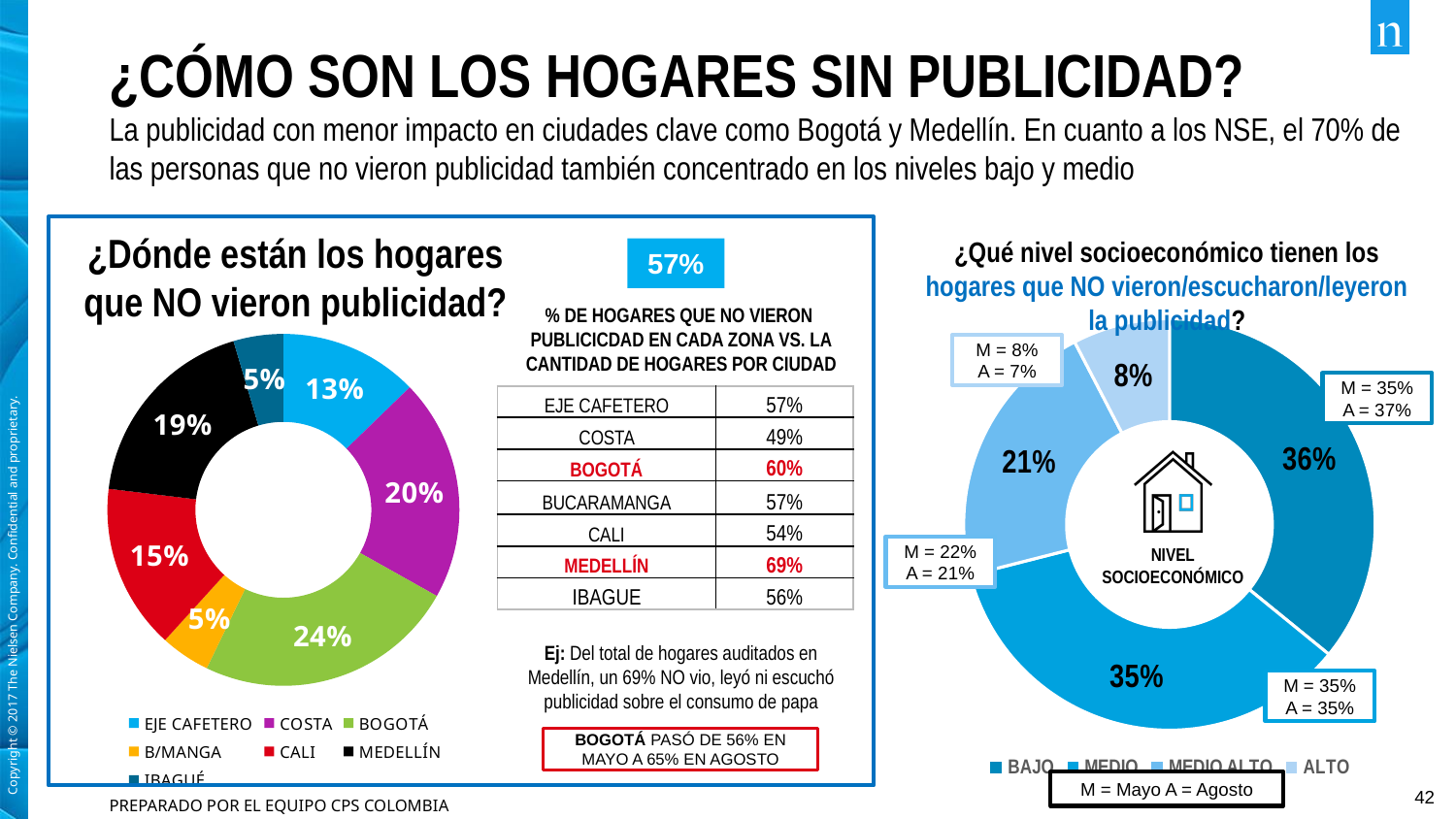
In the left doughnut chart (¿Dónde están los hogares que NO vieron publicidad?), what percentage is shown for MEDELLÍN? 19% In the left doughnut chart (¿Dónde están los hogares que NO vieron publicidad?), what is the difference between the COSTA and CALI shares? 5% In the left doughnut chart (¿Dónde están los hogares que NO vieron publicidad?), which category has the largest share? BOGOTÁ In the right doughnut chart (¿Qué nivel socioeconómico tienen los hogares...?), which socioeconomic level has the smallest share? ALTO In the left doughnut chart (¿Dónde están los hogares que NO vieron publicidad?), what percentage is shown for BOGOTÁ? 24% What type of chart is used on the left of the slide to show where the households that did not see advertising are? Doughnut chart In the right doughnut chart, what do the letters M and A in the callout boxes stand for, according to the note below the legend? M = Mayo, A = Agosto In the right doughnut chart (¿Qué nivel socioeconómico tienen los hogares...?), what is the difference between the BAJO and ALTO shares? 28% How many categories does the legend of the right doughnut chart (¿Qué nivel socioeconómico tienen los hogares...?) list? 4 In the left doughnut chart (¿Dónde están los hogares que NO vieron publicidad?), which is larger, EJE CAFETERO or MEDELLÍN? MEDELLÍN In the right doughnut chart (¿Qué nivel socioeconómico tienen los hogares...?), what percentage is shown for MEDIO ALTO? 21% How many categories does the legend of the left doughnut chart (¿Dónde están los hogares que NO vieron publicidad?) list? 7